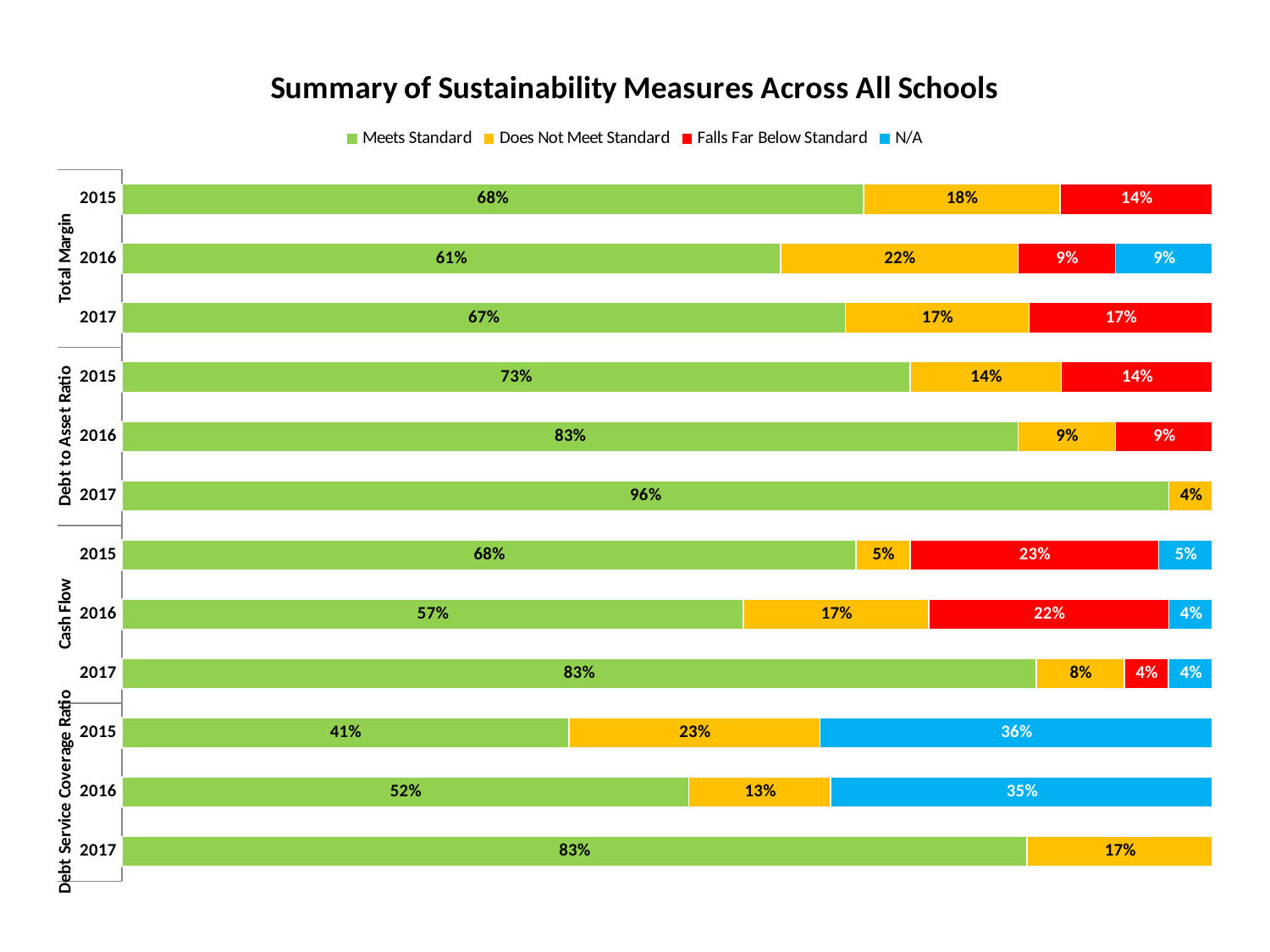
Which year has the lowest Meets Standard percentage for Debt Service Coverage Ratio? 2015 What kind of chart is shown on the slide? Stacked bar chart Which year has the highest Meets Standard percentage for Debt to Asset Ratio? 2017 What is the N/A share for Debt Service Coverage Ratio in 2015? 36% What percentage of schools fell far below the Cash Flow standard in 2016? 22% Which is larger: the Does Not Meet Standard share for Total Margin in 2016 or for Debt to Asset Ratio in 2016? Total Margin 2016 What percentage of schools met the Total Margin standard in 2015? 68% Which colour represents the N/A series in the chart? Blue What is the difference between the Meets Standard percentages for Cash Flow in 2017 and 2016? 26% What is the title of the chart? Summary of Sustainability Measures Across All Schools Does the Meets Standard percentage for Debt Service Coverage Ratio rise or fall from 2015 to 2017? Rise How many series does the legend list? 4